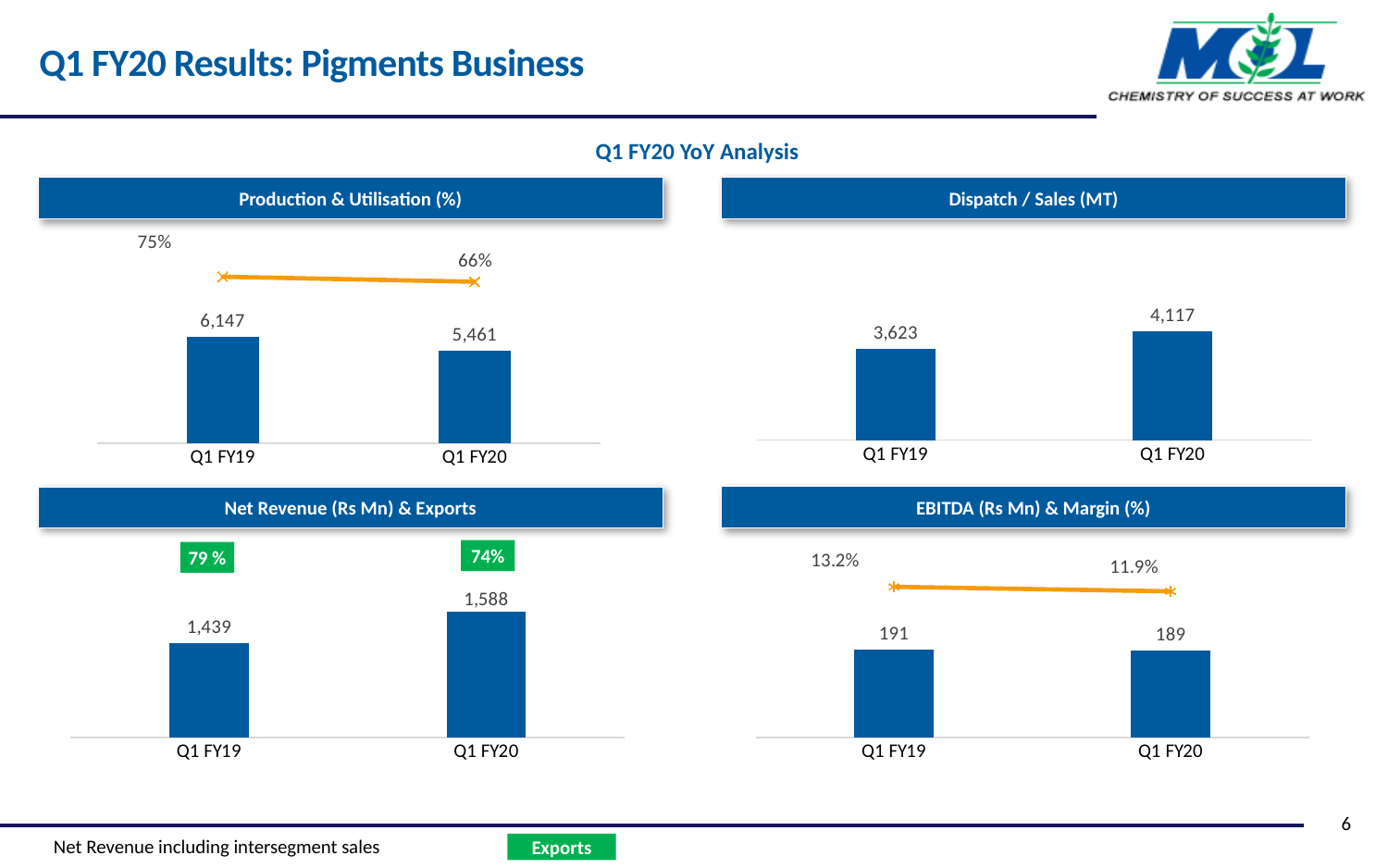
In the Production & Utilisation (%) chart, what is the production value for Q1 FY19? 6,147 In the Production & Utilisation (%) chart, what is the utilisation percentage for Q1 FY20? 66% In the Net Revenue (Rs Mn) & Exports chart, what is the net revenue for Q1 FY20? 1,588 In the Dispatch / Sales (MT) chart, what is the value for Q1 FY20? 4,117 In the Dispatch / Sales (MT) chart, what is the difference between Q1 FY20 and Q1 FY19? 494 In the Net Revenue (Rs Mn) & Exports chart, does net revenue rise or fall from Q1 FY19 to Q1 FY20? rise In the Production & Utilisation (%) chart, by how much did production fall from Q1 FY19 to Q1 FY20? 686 In the EBITDA (Rs Mn) & Margin (%) chart, what is the EBITDA for Q1 FY19? 191 In the EBITDA (Rs Mn) & Margin (%) chart, what is the margin for Q1 FY20? 11.9% In the Net Revenue (Rs Mn) & Exports chart, what is the exports share for Q1 FY19? 79 % What type of chart is the Dispatch / Sales (MT) chart? bar chart In the Dispatch / Sales (MT) chart, which quarter has the higher value? Q1 FY20